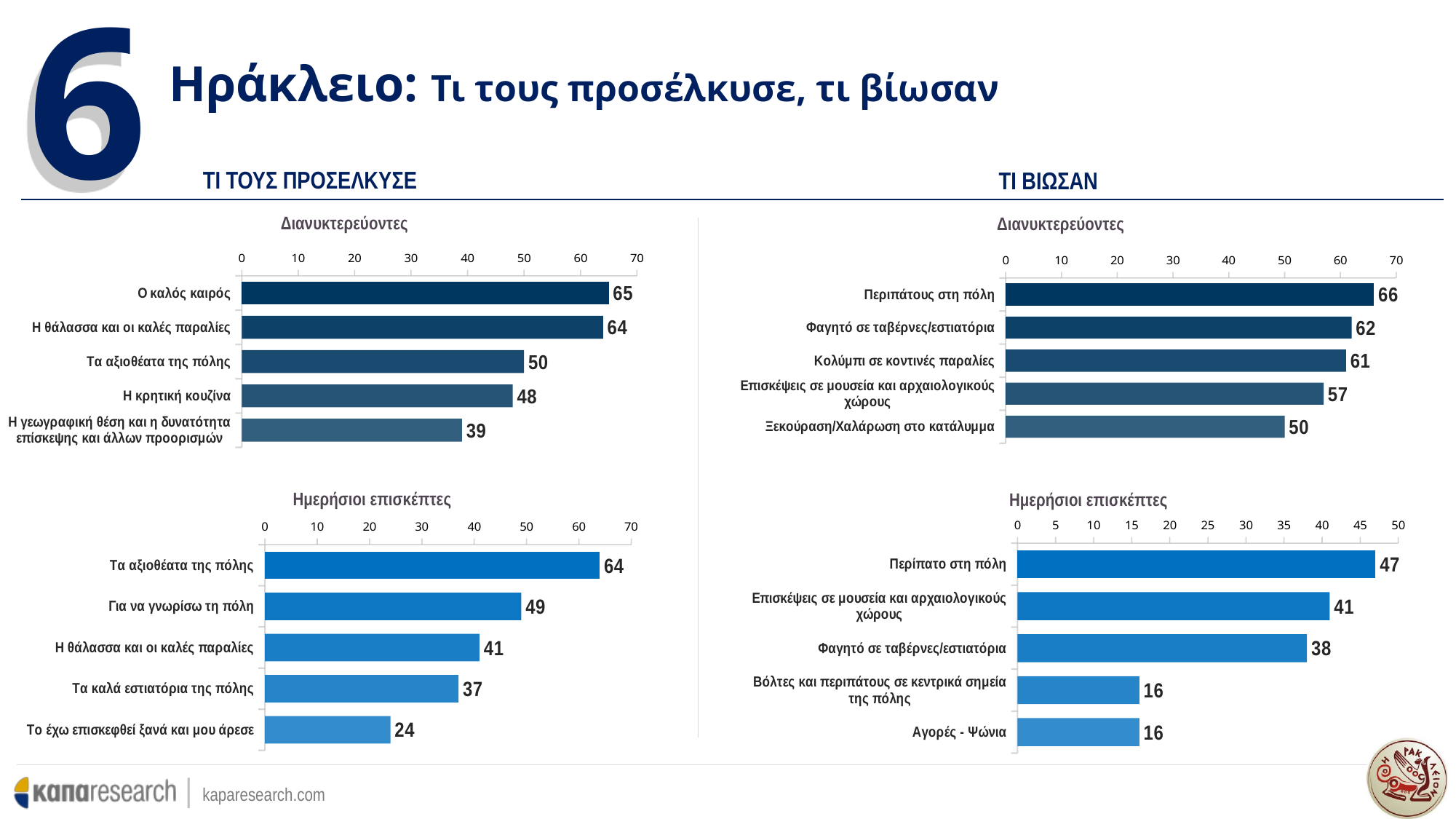
What kind of chart is the bottom-right chart (ΤΙ ΒΙΩΣΑΝ, Ημερήσιοι επισκέπτες)? bar chart In the bottom-right chart (ΤΙ ΒΙΩΣΑΝ, Ημερήσιοι επισκέπτες), what is the value for 'Αγορές - Ψώνια'? 16 In the top-right chart (ΤΙ ΒΙΩΣΑΝ, Διανυκτερεύοντες), which is larger: 'Περιπάτους στη πόλη' or 'Ξεκούραση/Χαλάρωση στο κατάλυμμα'? Περιπάτους στη πόλη In the bottom-left chart (ΤΙ ΤΟΥΣ ΠΡΟΣΕΛΚΥΣΕ, Ημερήσιοι επισκέπτες), how many categories are shown? 5 In the top-right chart (ΤΙ ΒΙΩΣΑΝ, Διανυκτερεύοντες), what is the difference between 'Φαγητό σε ταβέρνες/εστιατόρια' and 'Επισκέψεις σε μουσεία και αρχαιολογικούς χώρους'? 5 In the bottom-right chart (ΤΙ ΒΙΩΣΑΝ, Ημερήσιοι επισκέπτες), is the value for 'Περίπατο στη πόλη' greater or less than 45? greater In the top-left chart (ΤΙ ΤΟΥΣ ΠΡΟΣΕΛΚΥΣΕ, Διανυκτερεύοντες), what is the value for 'Ο καλός καιρός'? 65 In the bottom-left chart (ΤΙ ΤΟΥΣ ΠΡΟΣΕΛΚΥΣΕ, Ημερήσιοι επισκέπτες), what is the value for 'Το έχω επισκεφθεί ξανά και μου άρεσε'? 24 In the top-left chart (ΤΙ ΤΟΥΣ ΠΡΟΣΕΛΚΥΣΕ, Διανυκτερεύοντες), what is the difference between 'Τα αξιοθέατα της πόλης' and 'Η κρητική κουζίνα'? 2 In the top-right chart (ΤΙ ΒΙΩΣΑΝ, Διανυκτερεύοντες), what is the value for 'Κολύμπι σε κοντινές παραλίες'? 61 In the bottom-left chart (ΤΙ ΤΟΥΣ ΠΡΟΣΕΛΚΥΣΕ, Ημερήσιοι επισκέπτες), which category has the highest value? Τα αξιοθέατα της πόλης In the top-left chart (ΤΙ ΤΟΥΣ ΠΡΟΣΕΛΚΥΣΕ, Διανυκτερεύοντες), which category has the lowest value? Η γεωγραφική θέση και η δυνατότητα επίσκεψης και άλλων προορισμών